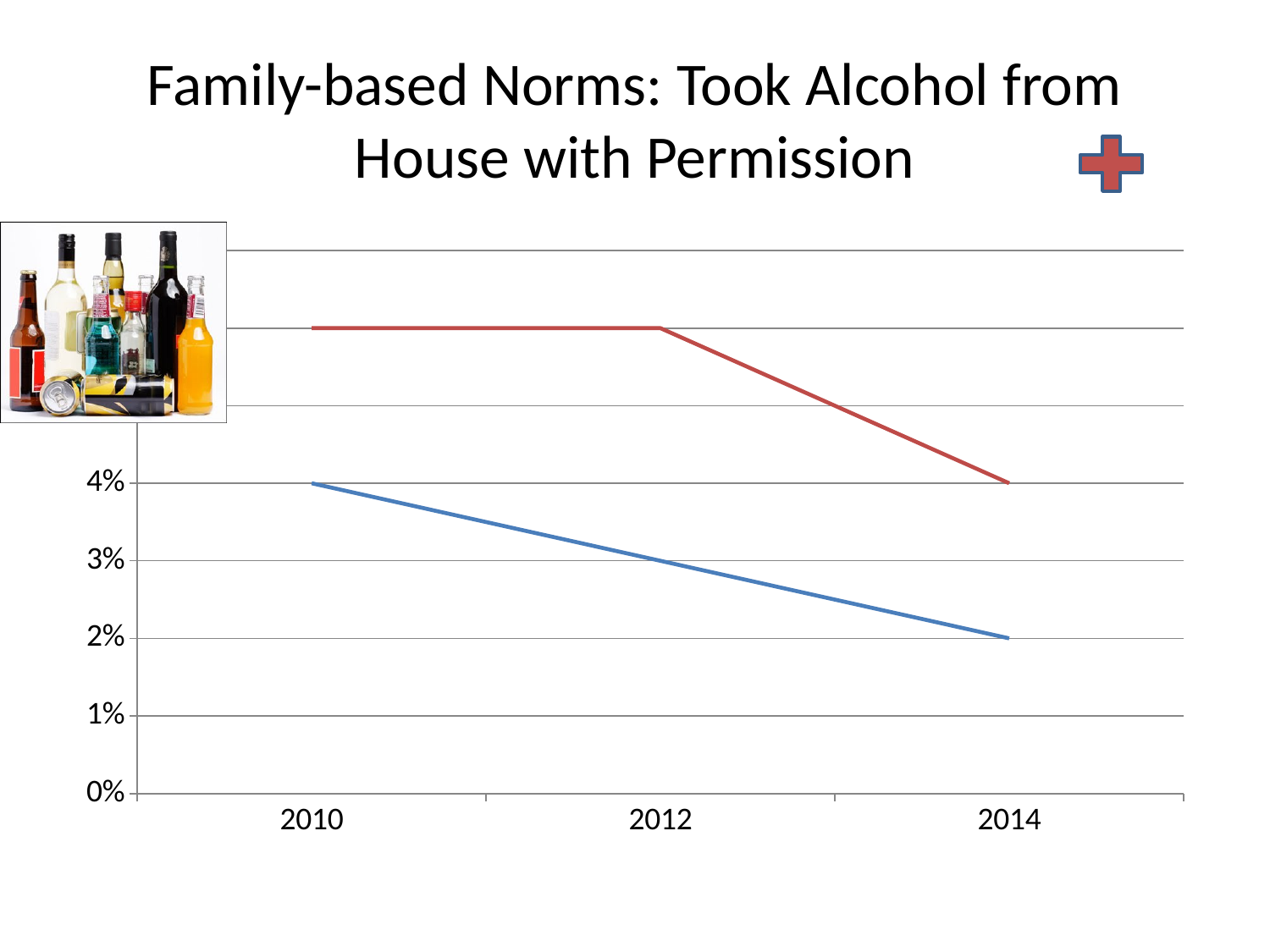
Which line has the higher value in 2014, the red line or the blue line? red line What is the title of the chart on the slide? Family-based Norms: Took Alcohol from House with Permission Is the value of the red line in 2010 greater or less than 4%? greater What is the value of the blue line in 2014? 2% How many years are shown on the x axis of the chart? 3 By how much did the blue line fall from 2010 to 2014? 2% How many lines are plotted on the chart? 2 In which year does the blue line reach its lowest value? 2014 Does the blue line rise or fall from 2010 to 2014? fall What is the value of the red line in 2014? 4% What kind of chart is shown on the slide? line chart What is the value of the blue line in 2010? 4%